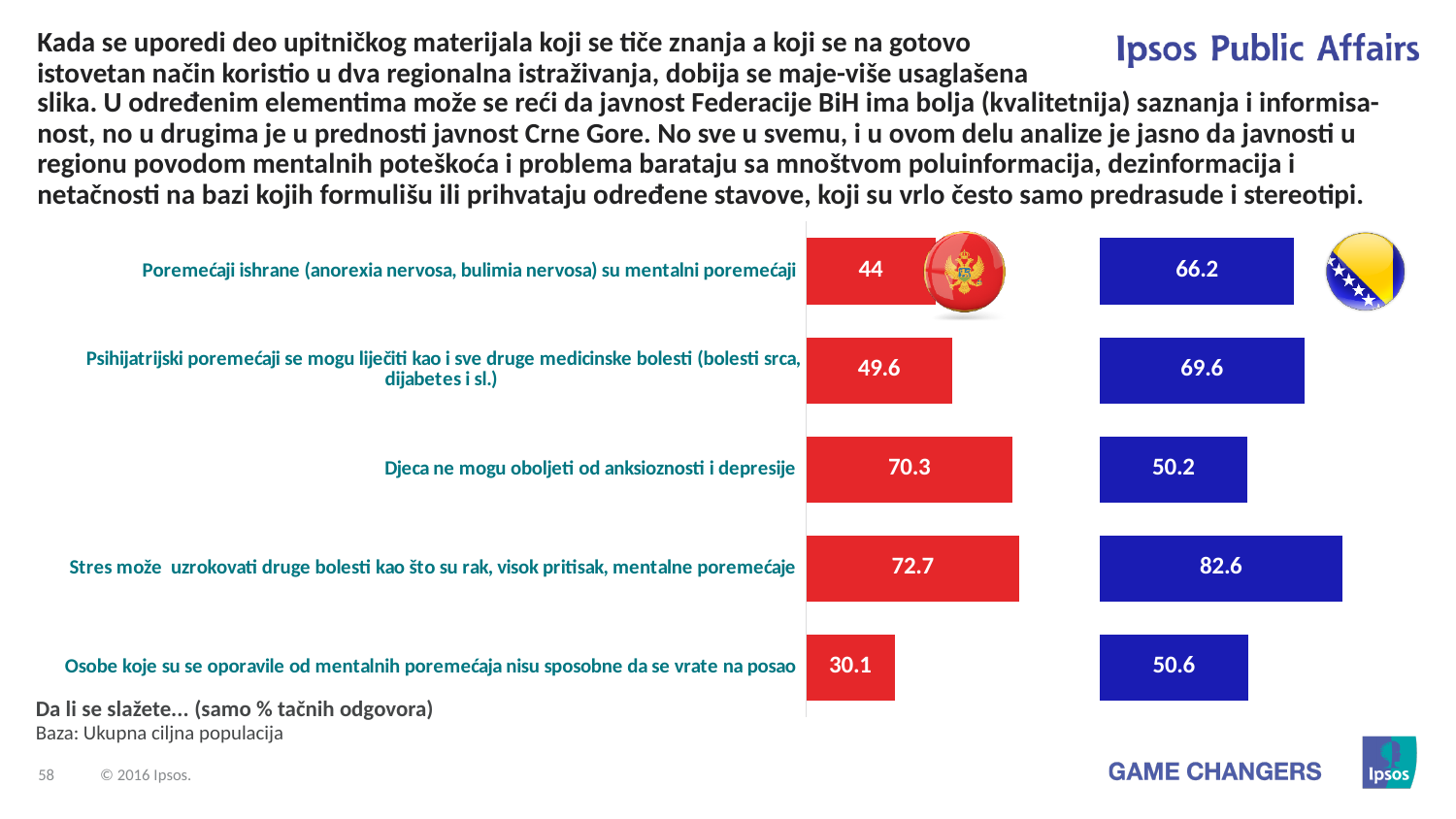
Which statement has the highest value among the blue bars? Stres može uzrokovati druge bolesti kao što su rak, visok pritisak, mentalne poremećaje Which statement has the highest value among the red bars? Stres može uzrokovati druge bolesti kao što su rak, visok pritisak, mentalne poremećaje What type of chart is shown on the slide? bar chart What is the value of the red bar for "Djeca ne mogu oboljeti od anksioznosti i depresije"? 70.3 For "Djeca ne mogu oboljeti od anksioznosti i depresije", is the red bar or the blue bar larger? red bar What is the difference between the blue bar and the red bar for "Stres može uzrokovati druge bolesti kao što su rak, visok pritisak, mentalne poremećaje"? 9.9 What is the value of the red bar for "Osobe koje su se oporavile od mentalnih poremećaja nisu sposobne da se vrate na posao"? 30.1 How many statements (categories) are shown in the chart? 5 What is the value of the blue bar for "Stres može uzrokovati druge bolesti kao što su rak, visok pritisak, mentalne poremećaje"? 82.6 What is the difference between the blue bar and the red bar for "Poremećaji ishrane (anorexia nervosa, bulimia nervosa) su mentalni poremećaji"? 22.2 Which statement has the lowest value among the red bars? Osobe koje su se oporavile od mentalnih poremećaja nisu sposobne da se vrate na posao How many series of bars does the chart show? 2